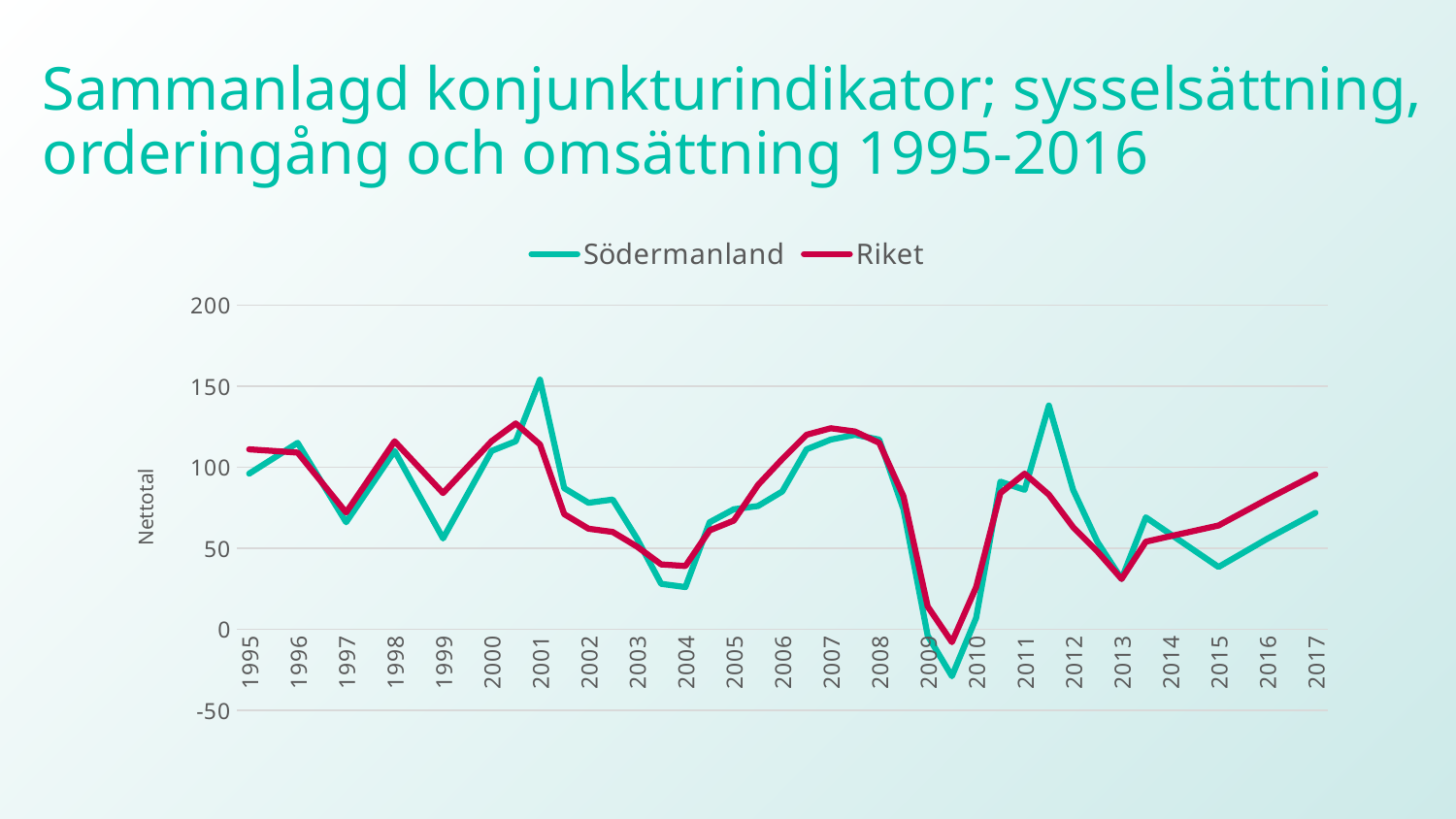
Does the Riket line rise or fall from 2013 to 2017? Rise Is the value for Södermanland in 2009 greater or less than 0? less In which year does the Södermanland line reach its highest value? 2001 What is the label on the vertical axis? Nettotal How many series does the legend list? 2 In which year does the Riket line reach its lowest value? 2009 Which two series are shown in the legend? Södermanland and Riket How many year labels are shown along the x axis? 23 What kind of chart is shown on the slide? Line chart Which series has the higher value in 2015, Södermanland or Riket? Riket In which year does the Södermanland line reach its lowest value? 2009